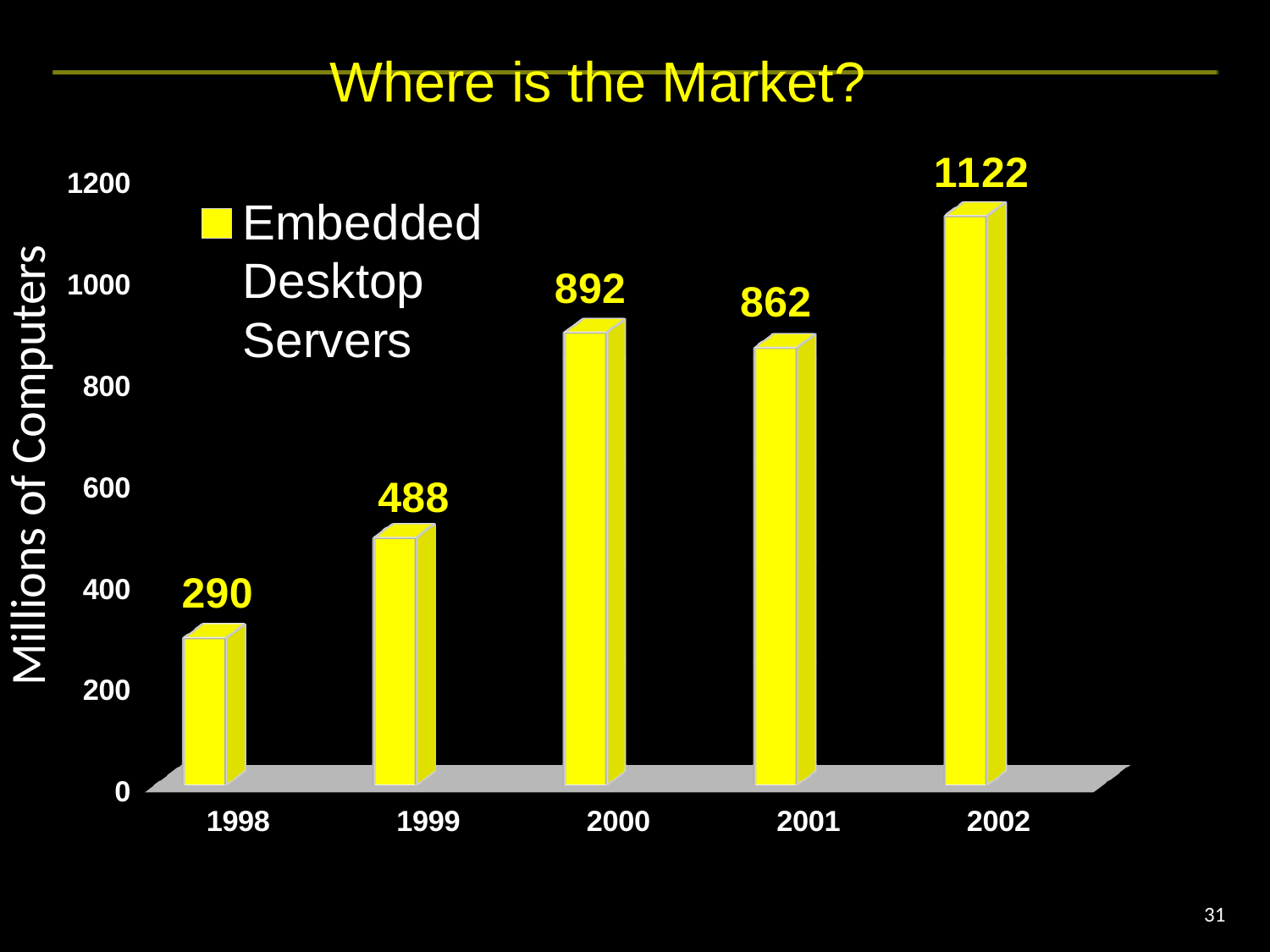
Which is larger, the value for 1999 or the value for 2001? 2001 What is the label on the vertical axis? Millions of Computers Which year has the highest value? 2002 What is the value for 1998? 290 How many years are shown on the x axis? 5 What kind of chart is shown? bar chart What is the difference between the values for 2000 and 2001? 30 Do the values generally rise or fall from 1998 to 2002? rise What is the value for 2002? 1122 What is the value for 2000? 892 What is the difference between the values for 2002 and 1998? 832 Which year has the lowest value? 1998